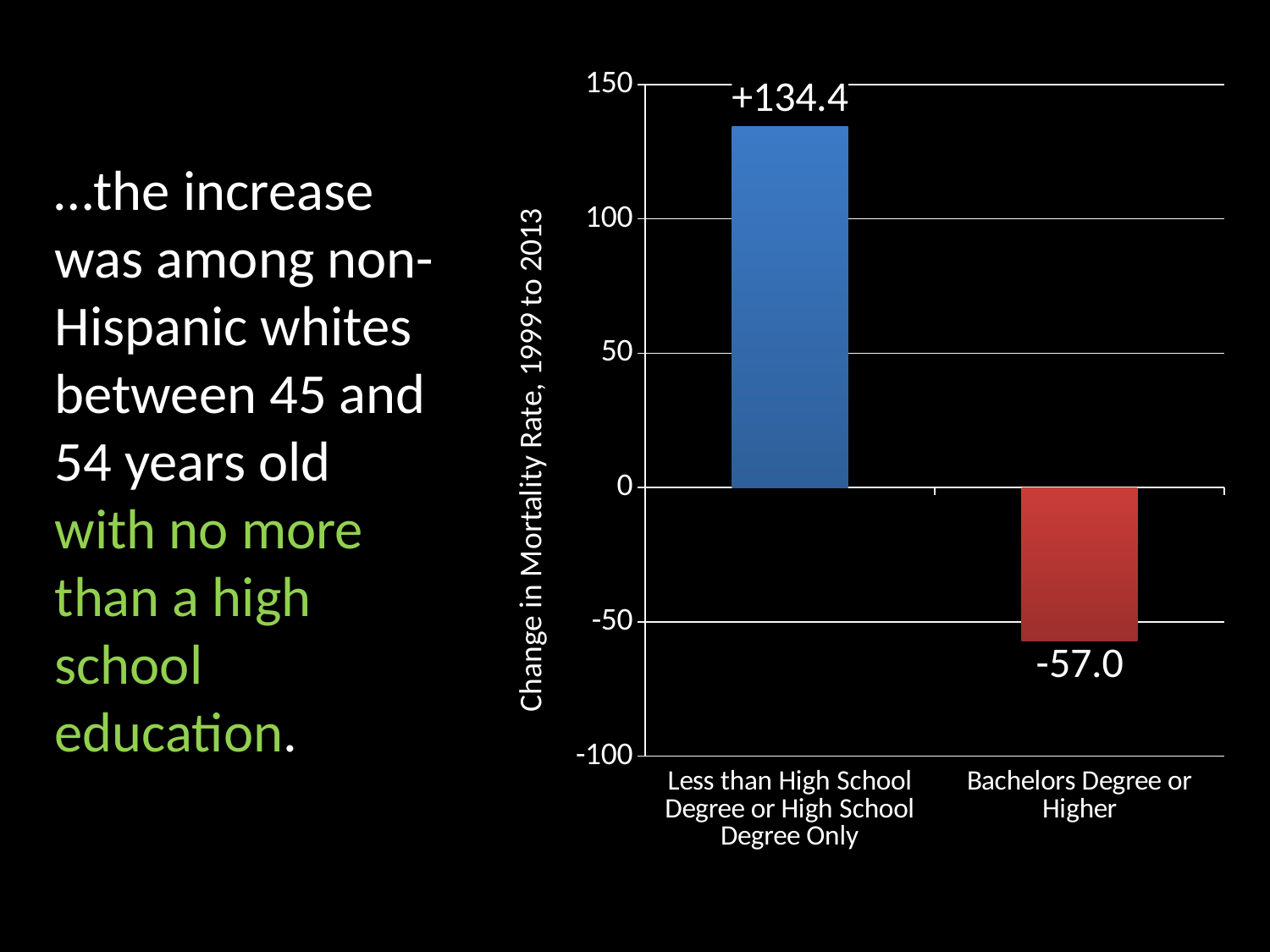
Is the value for Less than High School Degree or High School Degree Only greater or less than 100? greater What is the difference between the values for Less than High School Degree or High School Degree Only and Bachelors Degree or Higher? 191.4 What is the label of the vertical axis? Change in Mortality Rate, 1999 to 2013 Which category has the highest change in mortality rate? Less than High School Degree or High School Degree Only What colour is the bar for Bachelors Degree or Higher? red Is the value for Bachelors Degree or Higher greater or less than -50? less What is the change in mortality rate for Bachelors Degree or Higher? -57.0 Which category has the lowest change in mortality rate? Bachelors Degree or Higher How many categories are shown on the chart? 2 What kind of chart is shown on the slide? bar chart What is the change in mortality rate for Less than High School Degree or High School Degree Only? +134.4 Which is larger, the value for Less than High School Degree or High School Degree Only or the value for Bachelors Degree or Higher? Less than High School Degree or High School Degree Only